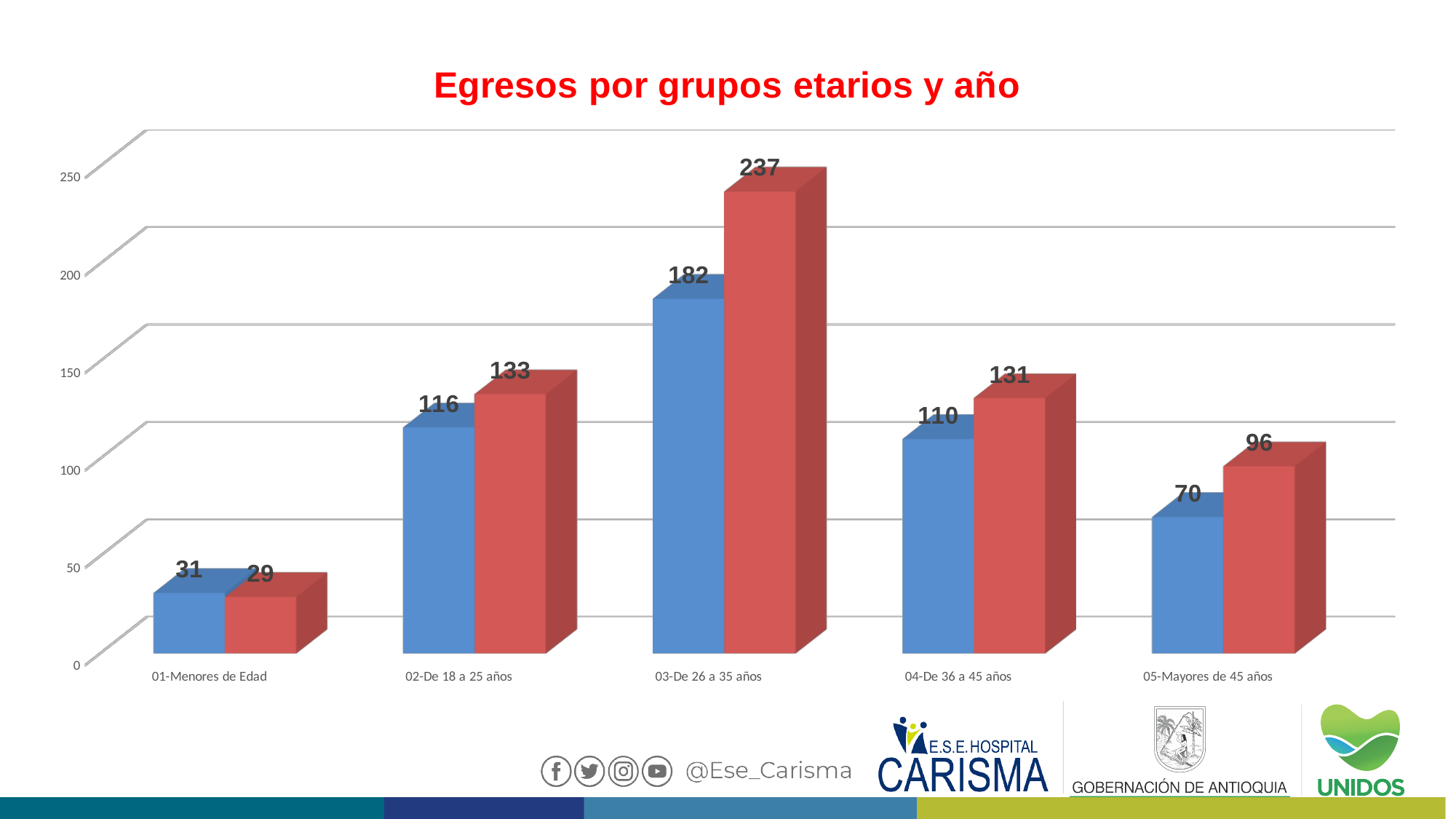
What is the difference between the red bars for 02-De 18 a 25 años and 04-De 36 a 45 años? 2 What is the difference between the red and blue bars for 03-De 26 a 35 años? 55 How many age groups are shown on the x axis? 5 What is the value of the red bar for 05-Mayores de 45 años? 96 What is the value of the red bar for 01-Menores de Edad? 29 Which age group has the highest red bar? 03-De 26 a 35 años What is the title of the chart? Egresos por grupos etarios y año For 01-Menores de Edad, which is larger, the blue bar or the red bar? the blue bar Which age group has the lowest blue bar? 01-Menores de Edad What is the value of the blue bar for 03-De 26 a 35 años? 182 Is the blue bar for 04-De 36 a 45 años greater or less than 100? greater What kind of chart is shown on the slide? bar chart